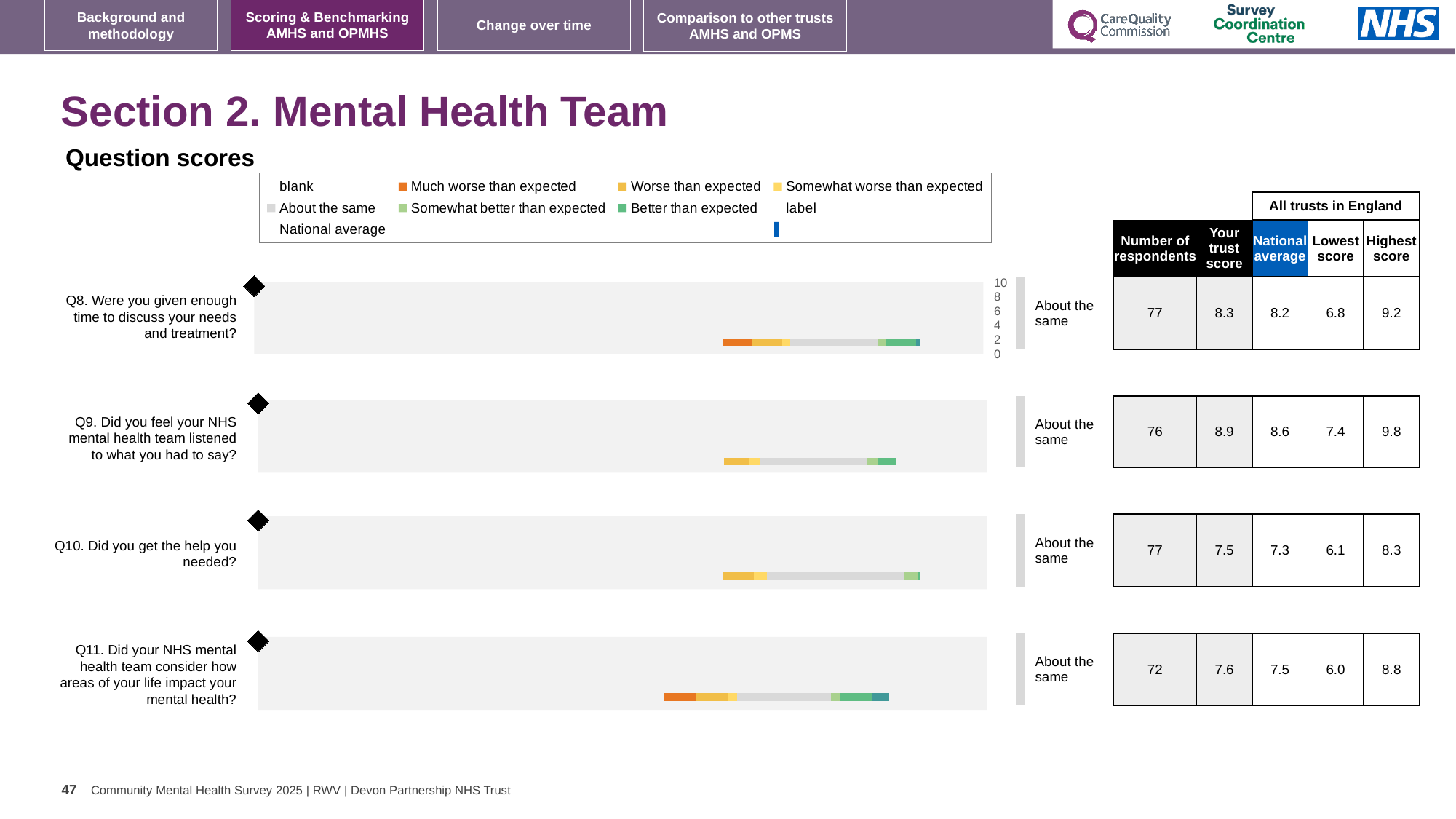
For Q8, what is the difference between the highest score (9.2) and the lowest score (6.8) across all trusts in England? 2.4 For Q9, how much higher is the trust score (8.9) than the national average (8.6)? 0.3 Which question has the lowest 'Lowest score' across all trusts in England? Q11 How many respondents are recorded for Q11 (Did your NHS mental health team consider how areas of your life impact your mental health?)? 72 What is the highest score across all trusts in England for Q11? 8.8 What is the national average score for Q8 (Were you given enough time to discuss your needs and treatment?)? 8.2 What kind of chart is used to show the question scores for Q8 to Q11? bar chart What benchmark label is shown next to the bar for Q10? About the same What is the 'Your trust score' value for Q9 (Did you feel your NHS mental health team listened to what you had to say?)? 8.9 How many questions (Q8 to Q11) have a score bar plotted on the slide? 4 For Q10 (Did you get the help you needed?), which is larger: the trust score or the national average? Your trust score (7.5) Which question has the highest 'Your trust score'? Q9